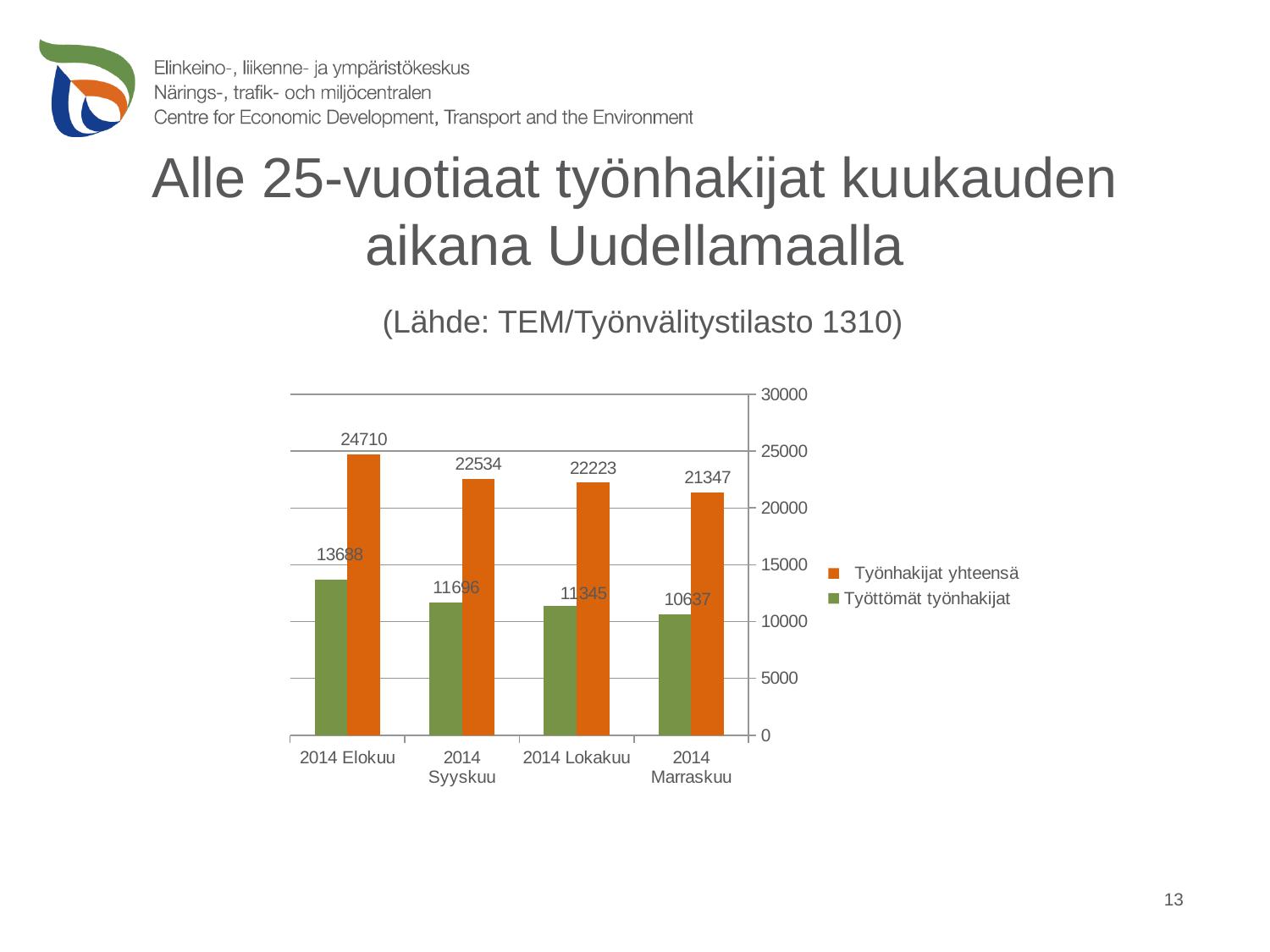
What is the value of Työnhakijat yhteensä for 2014 Elokuu? 24710 How many series does the legend list? 2 In which month is Työttömät työnhakijat lowest? 2014 Marraskuu What is the difference between Työnhakijat yhteensä and Työttömät työnhakijat in 2014 Syyskuu? 10838 What is the value of Työttömät työnhakijat for 2014 Marraskuu? 10637 Which is larger: Työnhakijat yhteensä in 2014 Syyskuu or in 2014 Marraskuu? 2014 Syyskuu What kind of chart is shown on the slide? Bar chart How many months (categories) are shown on the x axis? 4 What colour are the Työttömät työnhakijat bars? Green Do the Työnhakijat yhteensä values rise or fall from 2014 Elokuu to 2014 Marraskuu? Fall In which month is Työnhakijat yhteensä highest? 2014 Elokuu What is the value of Työnhakijat yhteensä for 2014 Lokakuu? 22223